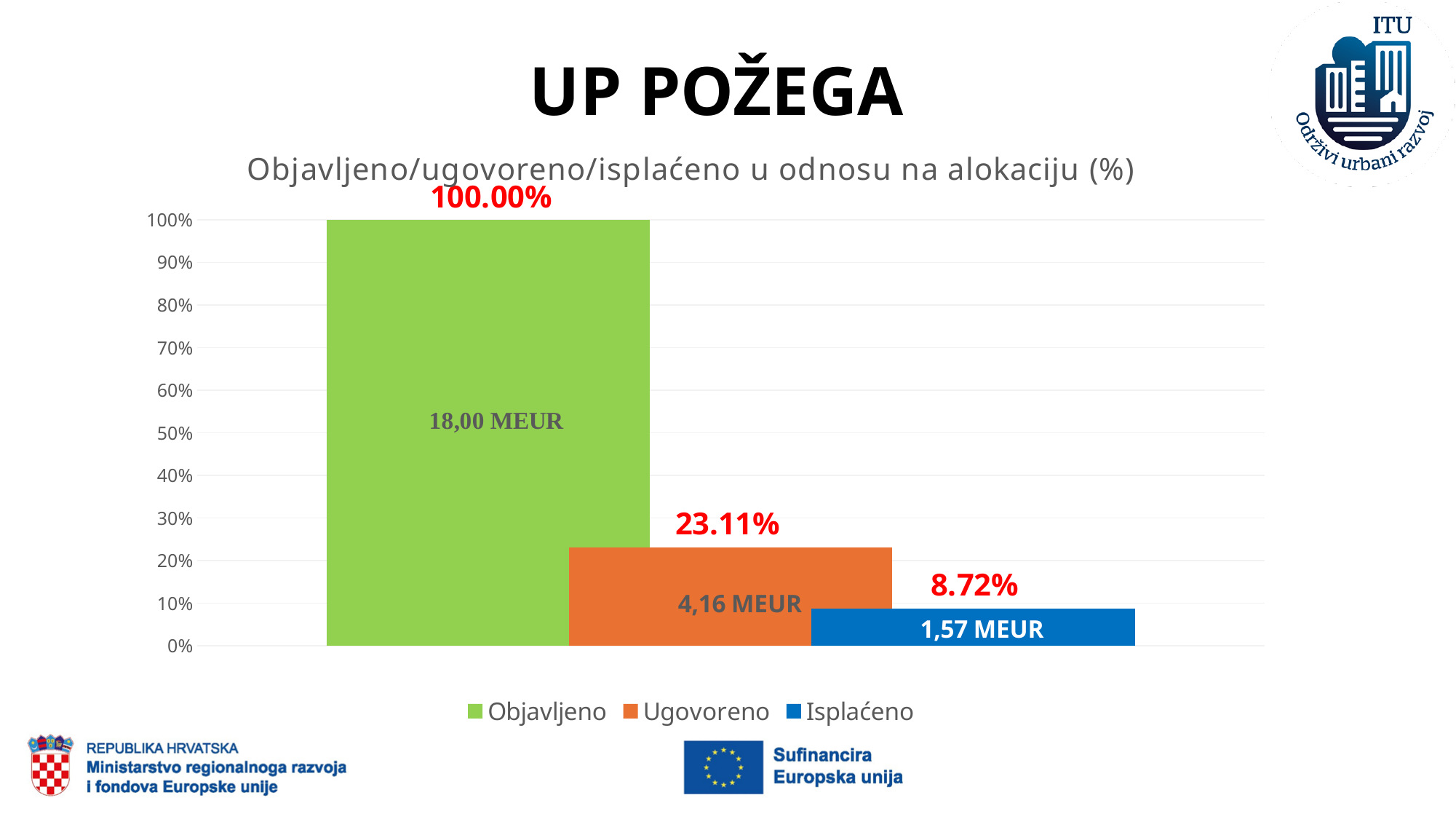
What percentage value is shown for Objavljeno? 100.00% Which is larger, the value for Ugovoreno or the value for Isplaćeno? Ugovoreno What amount in MEUR is labelled on the Isplaćeno bar? 1,57 MEUR What is the difference in percentage points between Ugovoreno and Isplaćeno? 14.39% Which series has the highest percentage value? Objavljeno Which series has the lowest percentage value? Isplaćeno What is the title of the chart? Objavljeno/ugovoreno/isplaćeno u odnosu na alokaciju (%) What percentage value is shown for Ugovoreno? 23.11% What amount in MEUR is labelled on the Ugovoreno bar? 4,16 MEUR What percentage value is shown for Isplaćeno? 8.72% How many series does the legend list? 3 What amount in MEUR is labelled on the Objavljeno bar? 18,00 MEUR